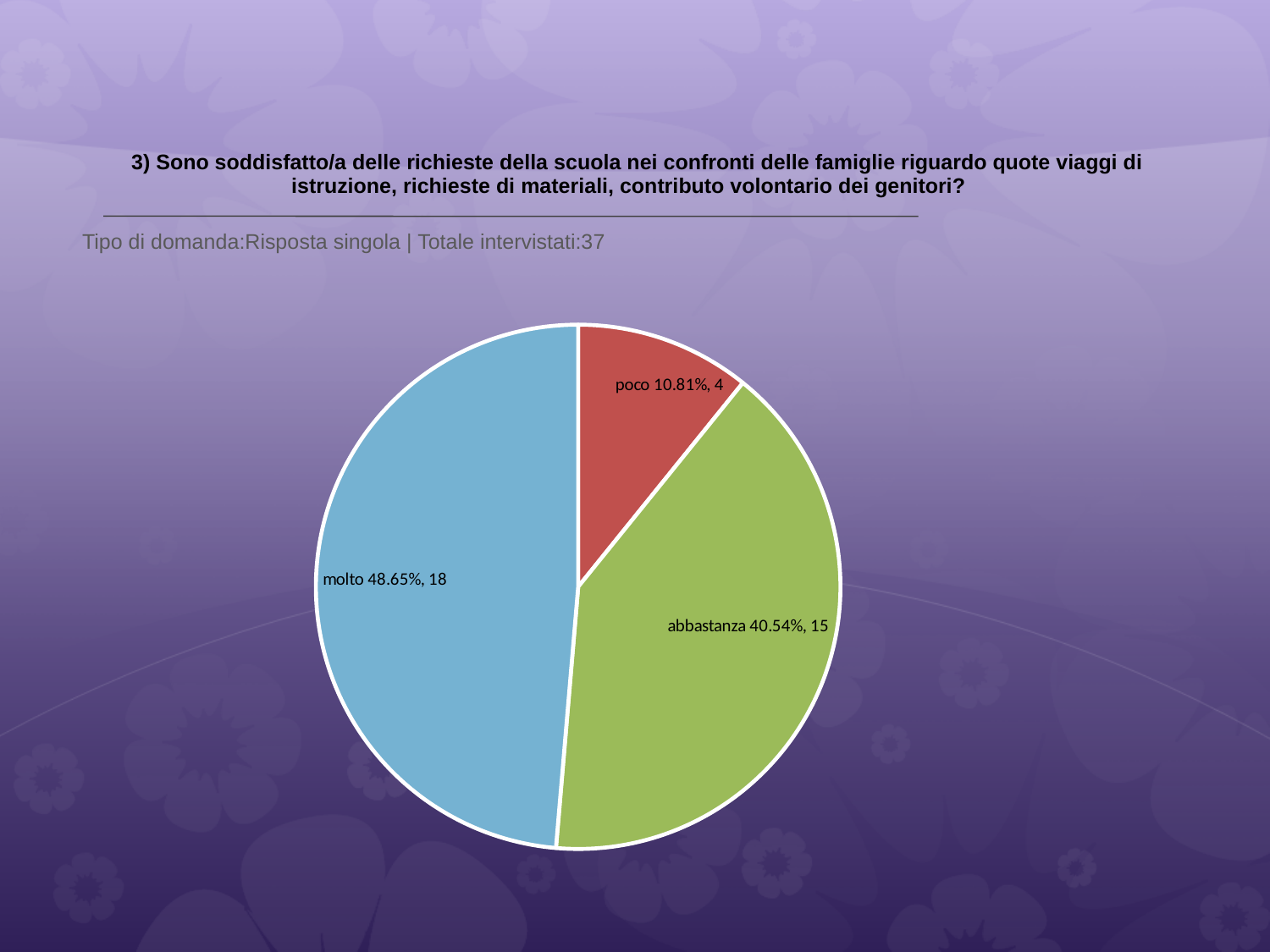
What percentage share does the 'poco' slice have? 10.81% How many slices does the pie chart have? 3 What is the difference in respondent count between 'molto' and 'abbastanza'? 3 Which category has the smallest slice? poco What percentage share does the 'molto' slice have? 48.65% What percentage share does the 'abbastanza' slice have? 40.54% How many respondents answered 'molto'? 18 What colour is the 'poco' slice? red Which category has the largest slice? molto What kind of chart is shown on the slide? pie chart How many respondents answered 'abbastanza'? 15 How many respondents answered 'poco'? 4